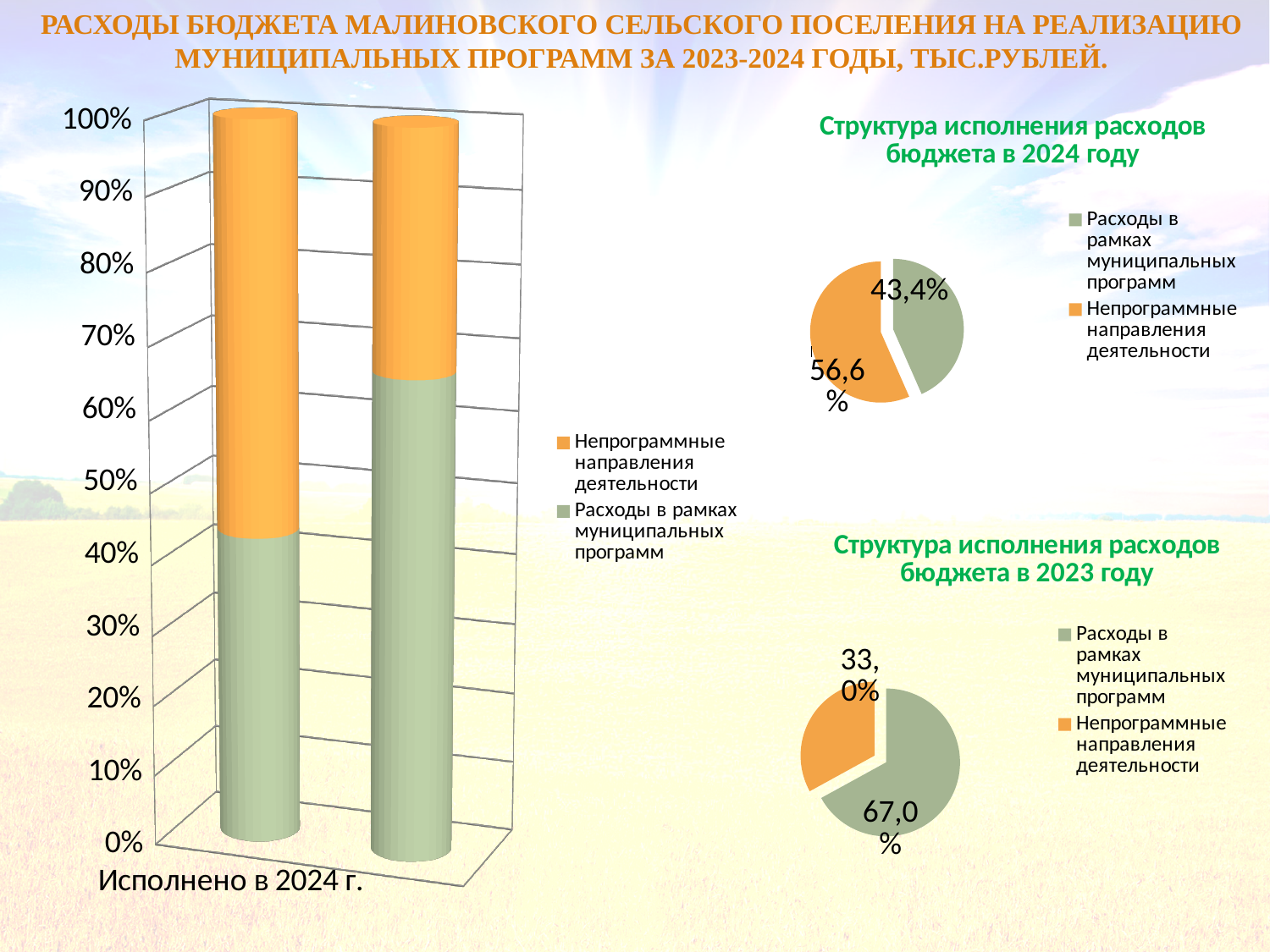
In the pie chart for 2024, which category has the larger share? Непрограммные направления деятельности In the pie chart titled 'Структура исполнения расходов бюджета в 2023 году', what share is shown for 'Расходы в рамках муниципальных программ'? 67,0% In the pie chart for 2023, what is the difference in percentage points between 'Расходы в рамках муниципальных программ' and 'Непрограммные направления деятельности'? 34,0 In the pie chart for 2024, what is the difference in percentage points between 'Непрограммные направления деятельности' and 'Расходы в рамках муниципальных программ'? 13,2 In the pie chart titled 'Структура исполнения расходов бюджета в 2023 году', what share is shown for 'Непрограммные направления деятельности'? 33,0% How many series does the legend of the bar chart on the left list? 2 In the pie chart titled 'Структура исполнения расходов бюджета в 2024 году', what share is shown for 'Непрограммные направления деятельности'? 56,6% In the bar chart on the left, is the green segment ('Расходы в рамках муниципальных программ') of the bar labelled 'Исполнено в 2024 г.' greater or less than 50%? less In the pie chart titled 'Структура исполнения расходов бюджета в 2024 году', what share is shown for 'Расходы в рамках муниципальных программ'? 43,4% Is the share of 'Расходы в рамках муниципальных программ' larger in the 2023 pie chart or in the 2024 pie chart? 2023 What kind of chart is the large chart on the left side of the slide? Stacked bar chart In the pie chart for 2023, which category has the smaller share? Непрограммные направления деятельности